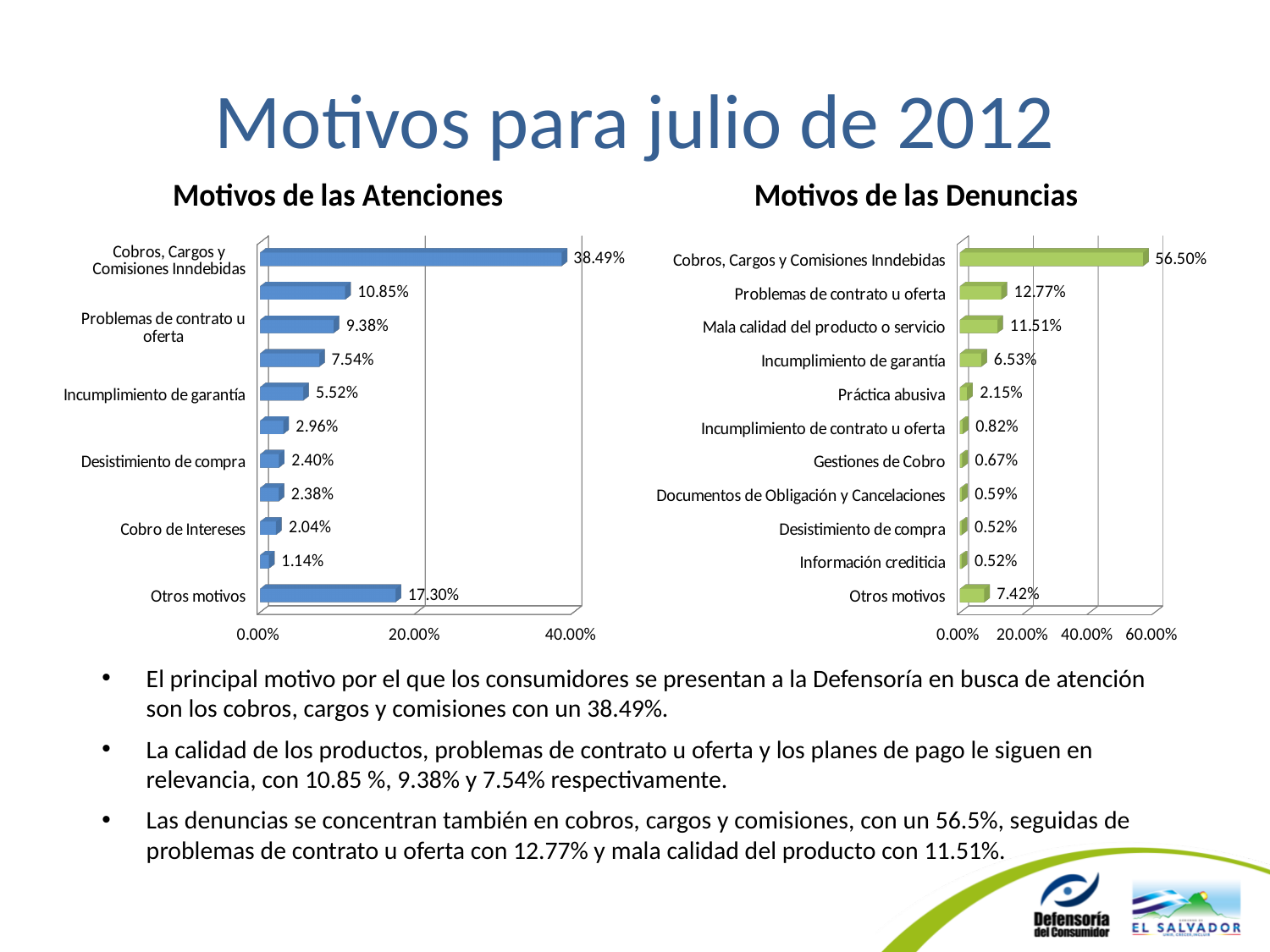
What kind of chart is the 'Motivos de las Denuncias' chart? Bar chart In the 'Motivos de las Denuncias' chart, what is the difference between Problemas de contrato u oferta and Mala calidad del producto o servicio? 1.26% In the 'Motivos de las Denuncias' chart, what is the value for Mala calidad del producto o servicio? 11.51% In the 'Motivos de las Denuncias' chart, what is the value for Cobros, Cargos y Comisiones Inndebidas? 56.50% In the 'Motivos de las Atenciones' chart, what is the value for Otros motivos? 17.30% In the 'Motivos de las Atenciones' chart, which is larger: Desistimiento de compra or Cobro de Intereses? Desistimiento de compra In the 'Motivos de las Atenciones' chart, which category has the highest value? Cobros, Cargos y Comisiones Inndebidas In the 'Motivos de las Atenciones' chart, what is the value for Problemas de contrato u oferta? 9.38% In the 'Motivos de las Atenciones' chart, what is the difference between Cobros, Cargos y Comisiones Inndebidas and Otros motivos? 21.19% In the 'Motivos de las Denuncias' chart, what is the value for Práctica abusiva? 2.15% In the 'Motivos de las Denuncias' chart, which category has the highest value? Cobros, Cargos y Comisiones Inndebidas How many categories are shown in the 'Motivos de las Denuncias' chart? 11